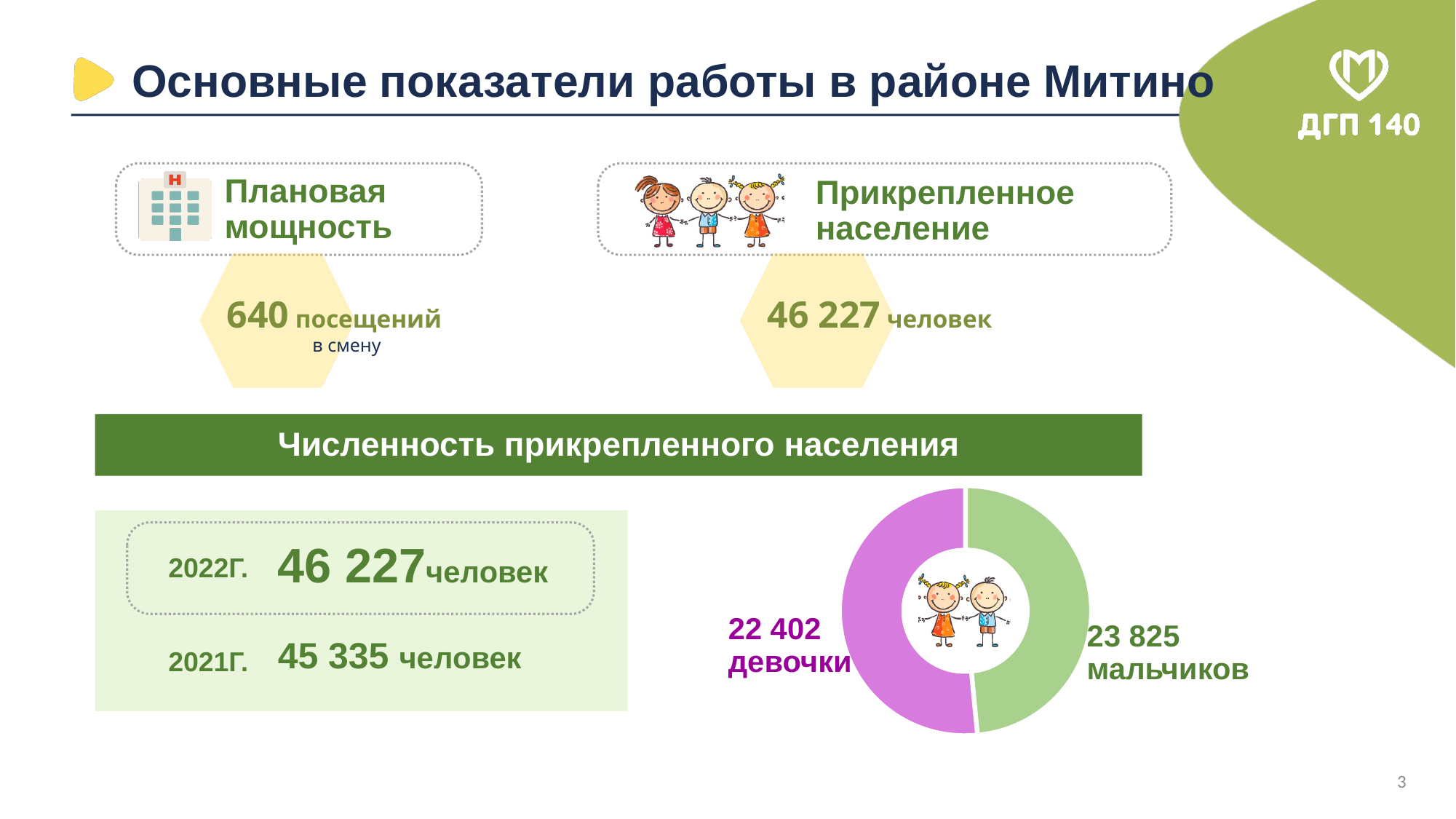
What is the total of the two slices in the donut chart? 46 227 What type of chart is shown on the slide? Donut (pie) chart What is the value for мальчиков (boys) in the donut chart? 23 825 What colour is the девочки slice in the donut chart? Pink (magenta) Which slice of the donut chart is larger: девочки or мальчиков? мальчиков What is the difference between the number of мальчиков and девочки in the donut chart? 1 423 Which category has the largest value in the donut chart? мальчиков How many slices does the donut chart have? 2 What colour is the мальчиков slice in the donut chart? Green Which category has the smallest value in the donut chart? девочки What is the value for девочки (girls) in the donut chart? 22 402